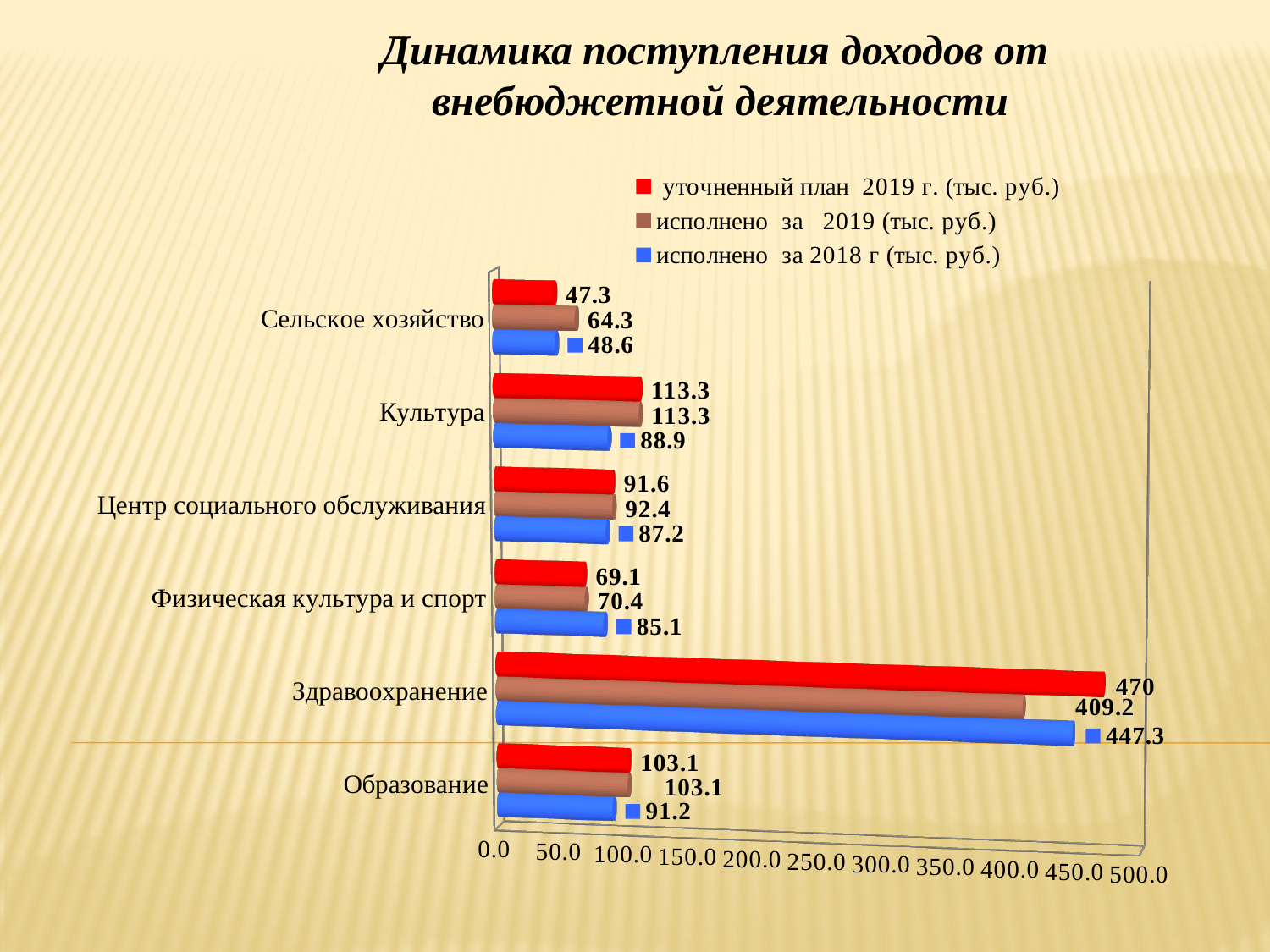
What colour represents the series «исполнено за 2018 г (тыс. руб.)»? Blue Which category has the lowest value for «уточненный план 2019 г.»? Сельское хозяйство For Сельское хозяйство, what is the difference between «исполнено за 2019» and «исполнено за 2018 г»? 15.7 Which category has the highest value for «исполнено за 2019»? Здравоохранение How many categories are shown on the chart? 6 What is the value of «уточненный план 2019 г.» for Здравоохранение? 470 What is the value of «исполнено за 2018 г» for Культура? 88.9 For Физическая культура и спорт, which is larger: «исполнено за 2018 г» or «исполнено за 2019»? исполнено за 2018 г How many series does the legend list? 3 What kind of chart is shown on the slide? Bar chart For Здравоохранение, how much larger is «уточненный план 2019 г.» than «исполнено за 2019»? 60.8 What is the value of «исполнено за 2019» for Сельское хозяйство? 64.3